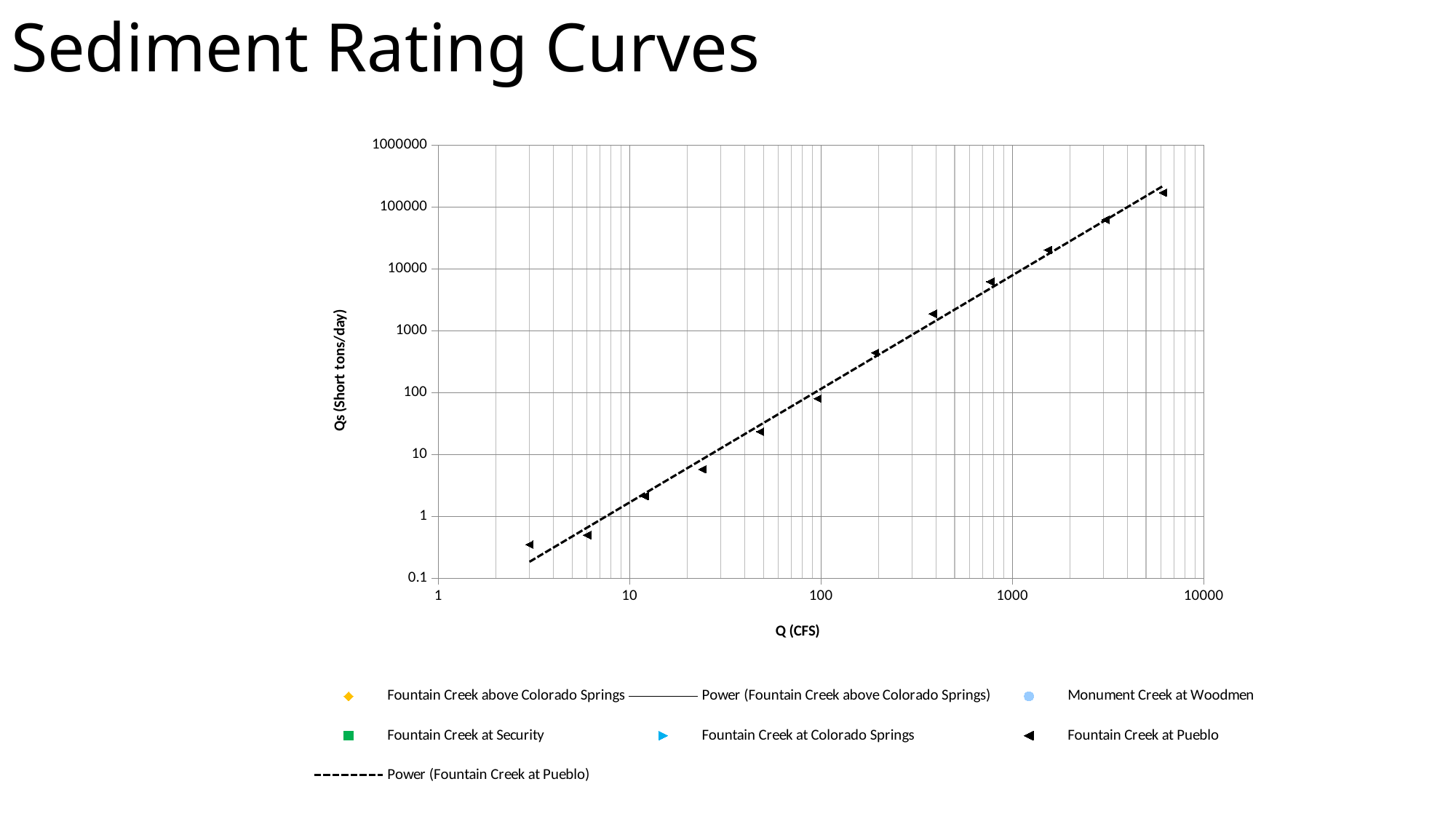
Do the Fountain Creek at Pueblo values rise or fall as Q increases along the x axis? rise What is the highest value shown on the y axis? 1000000 How many Fountain Creek at Pueblo data points are plotted? 12 Is the Qs value for the Fountain Creek at Pueblo point at Q = 100 CFS greater or less than 100? less Is the Qs value for the rightmost Fountain Creek at Pueblo point greater or less than 100000? greater How many entries does the legend list? 7 What kind of chart is shown on the slide? scatter chart Is the Qs value for the Fountain Creek at Pueblo point nearest Q = 1000 CFS greater or less than 1000? greater What is the title of the x axis? Q (CFS) Which legend entry is drawn as a dashed line? Power (Fountain Creek at Pueblo)